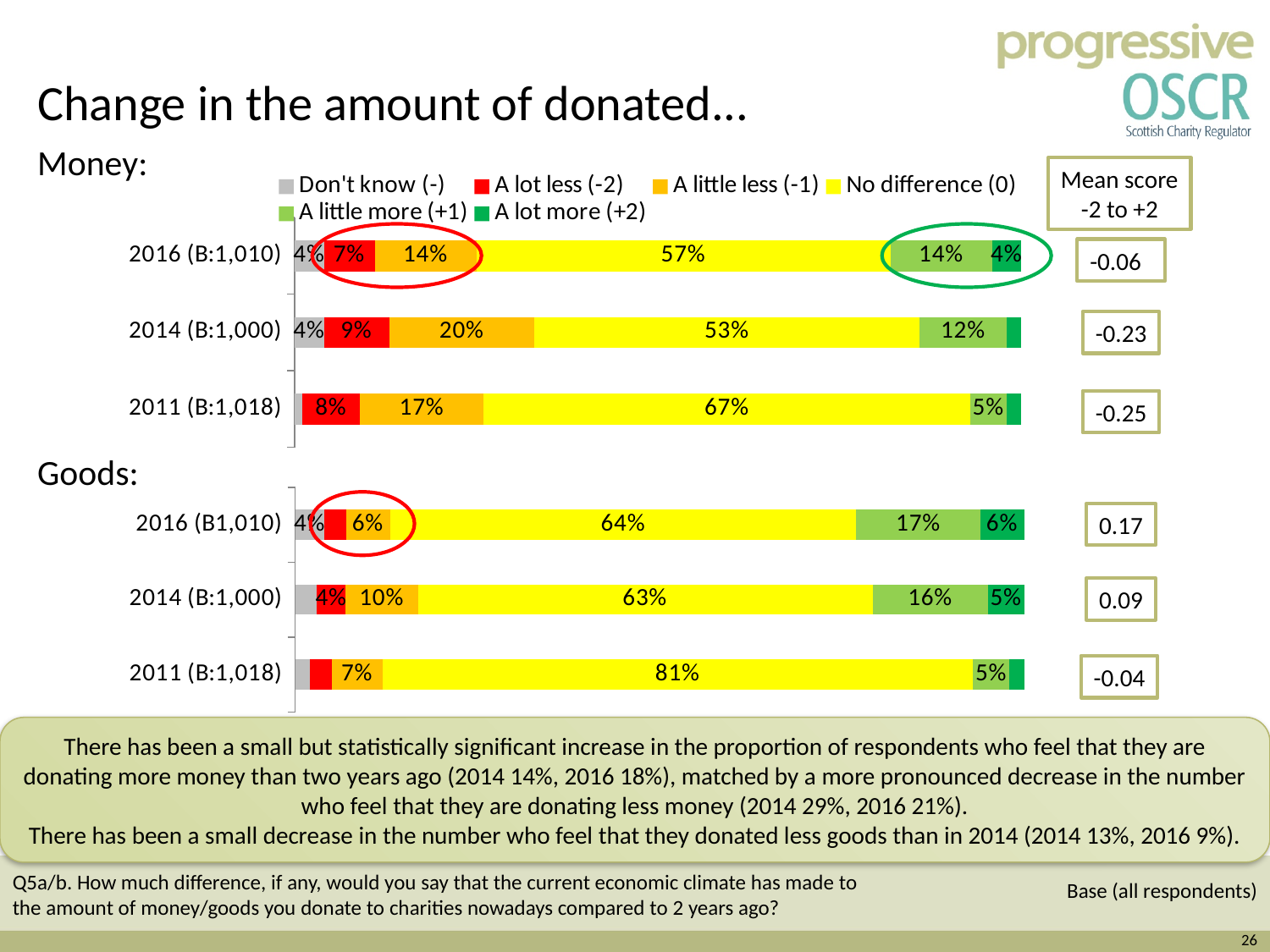
In the Money chart, by how many percentage points did the 'A little less (-1)' share fall from 2014 (B:1,000) to 2016 (B:1,010)? 6 percentage points What kind of chart is used to show the change in the amount of money donated? Stacked bar chart What colour represents the 'No difference (0)' series in the charts? Yellow In the Goods chart, what is the 'A little more (+1)' value for 2016 (B1,010)? 17% In the Goods chart, which year has the lowest 'No difference (0)' share? 2014 (B:1,000) In the Money chart, is the 'A lot less (-2)' share larger in 2014 (B:1,000) or in 2016 (B:1,010)? 2014 (B:1,000) How many years (bars) are shown in the Money chart? 3 In the Money chart, which year has the highest 'No difference (0)' share? 2011 (B:1,018) How many series does the legend list for the charts? 6 In the Goods chart, what is the 'No difference (0)' value for 2011 (B:1,018)? 81% In the Money chart, what is the 'A little less (-1)' value for 2011 (B:1,018)? 17% In the Money chart, what percentage of respondents in 2016 (B:1,010) said there was no difference in the amount of money donated? 57%